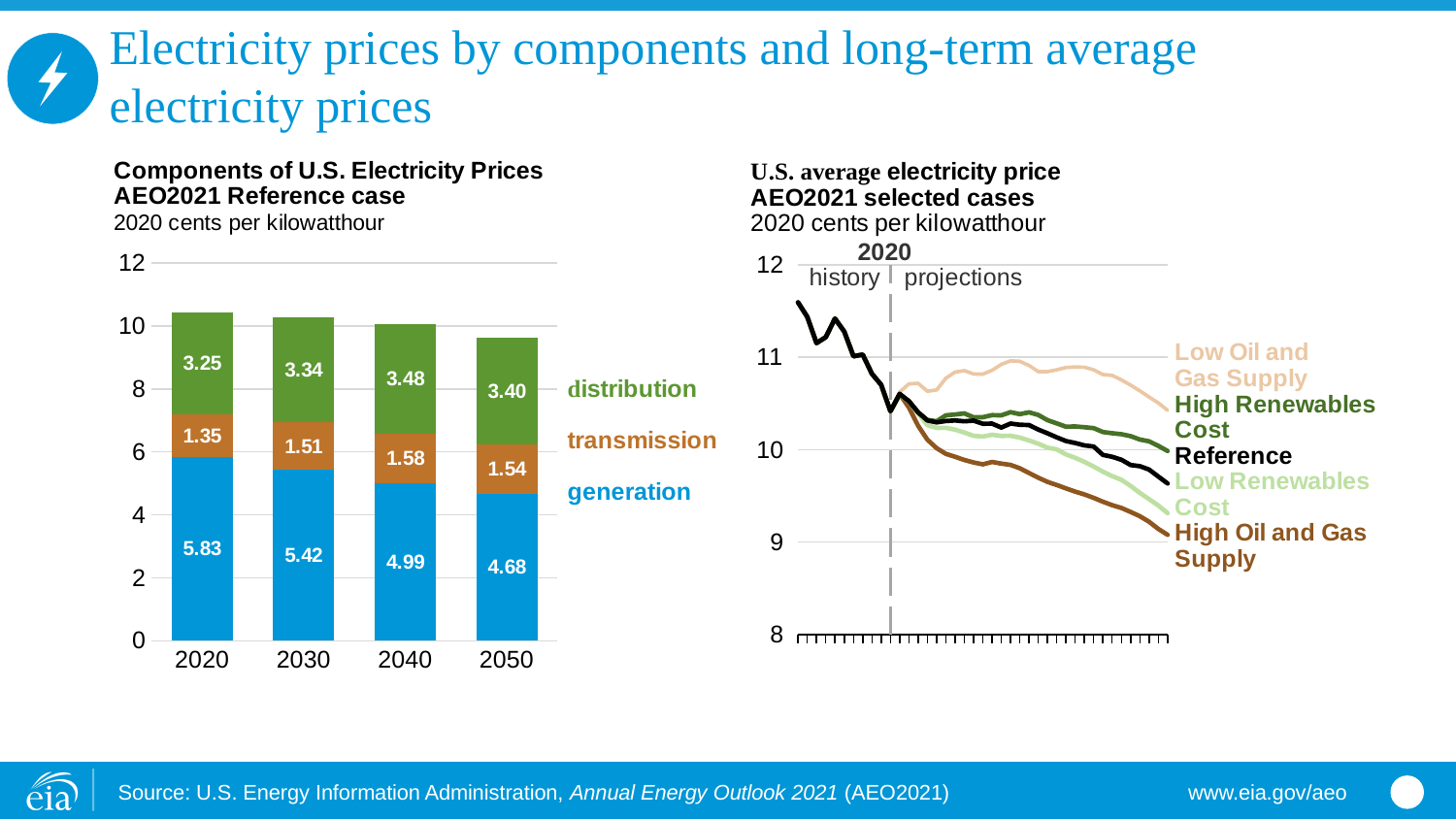
In the Components of U.S. Electricity Prices chart, which year has the lowest transmission value? 2020 In the Components of U.S. Electricity Prices chart, what is the total of the stacked bar for 2050? 9.62 In the Components of U.S. Electricity Prices chart, is the distribution value larger in 2030 or 2040? 2040 In the Components of U.S. Electricity Prices chart, what is the distribution value for 2040? 3.48 In the Components of U.S. Electricity Prices chart, what is the generation value for 2020? 5.83 In the Components of U.S. Electricity Prices chart, how does the generation component change from 2020 to 2050? It falls How many series does the U.S. average electricity price chart on the right show? 5 In the U.S. average electricity price chart on the right, which case has the highest price at the end of the projection period? Low Oil and Gas Supply In the Components of U.S. Electricity Prices chart, which year has the highest generation value? 2020 In the Components of U.S. Electricity Prices chart, what is the difference between the generation values for 2020 and 2050? 1.15 In the U.S. average electricity price chart on the right, is the High Oil and Gas Supply value at the end of the projection period greater or less than 10? less In the Components of U.S. Electricity Prices chart, what is the transmission value for 2050? 1.54